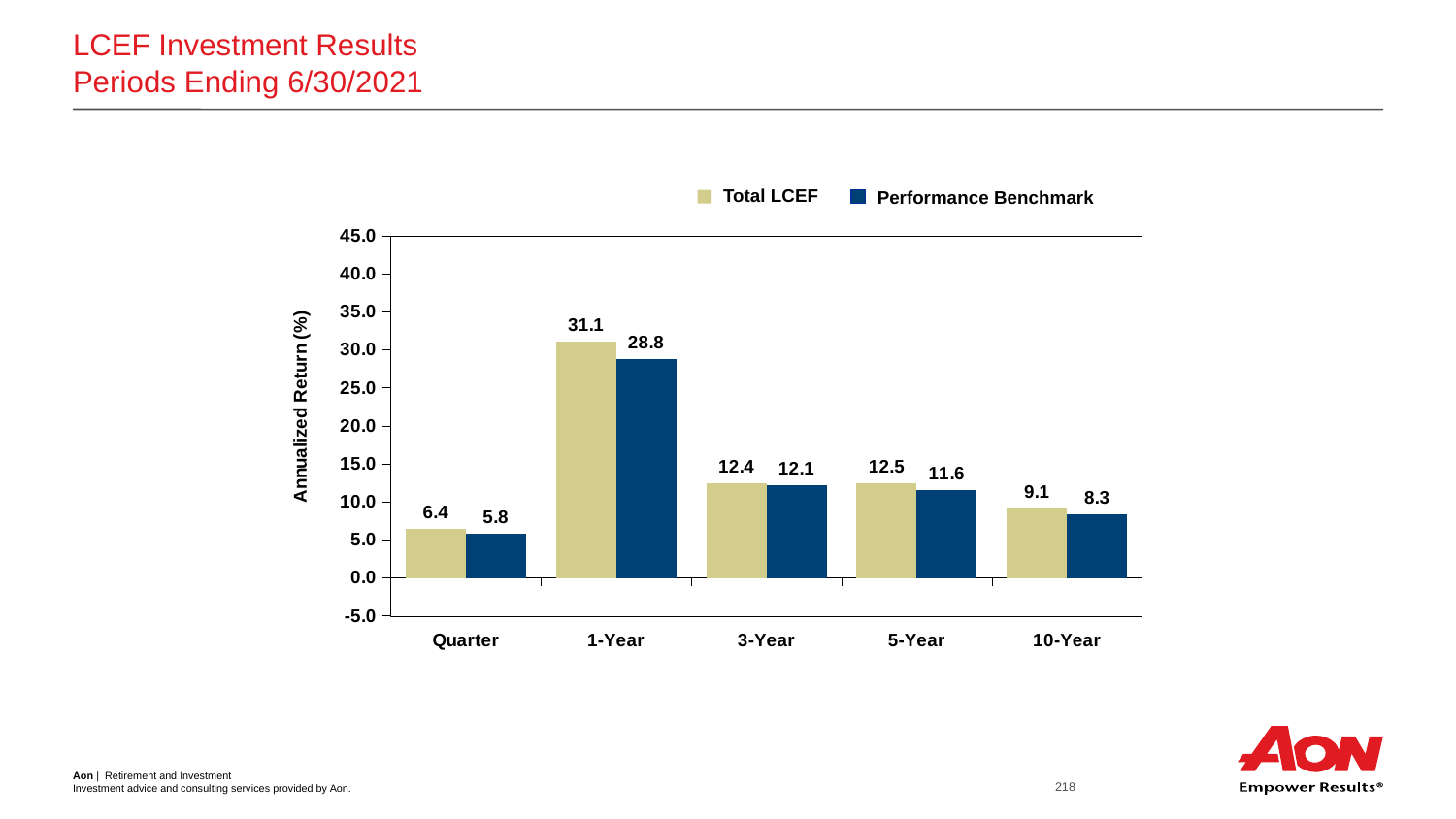
What is the Total LCEF annualized return for the 1-Year period? 31.1 What kind of chart is shown on the slide? Bar chart Which period has the highest Total LCEF return? 1-Year What is the Total LCEF value for the Quarter period? 6.4 What is the label of the y axis? Annualized Return (%) Which period has the lowest Performance Benchmark return? Quarter How many periods are shown on the x axis? 5 What is the Performance Benchmark value for the 10-Year period? 8.3 What is the difference between Total LCEF and Performance Benchmark for the 5-Year period? 0.9 For the 3-Year period, which is larger: Total LCEF or Performance Benchmark? Total LCEF What is the difference between Total LCEF and Performance Benchmark for the 1-Year period? 2.3 How many series does the legend list? 2